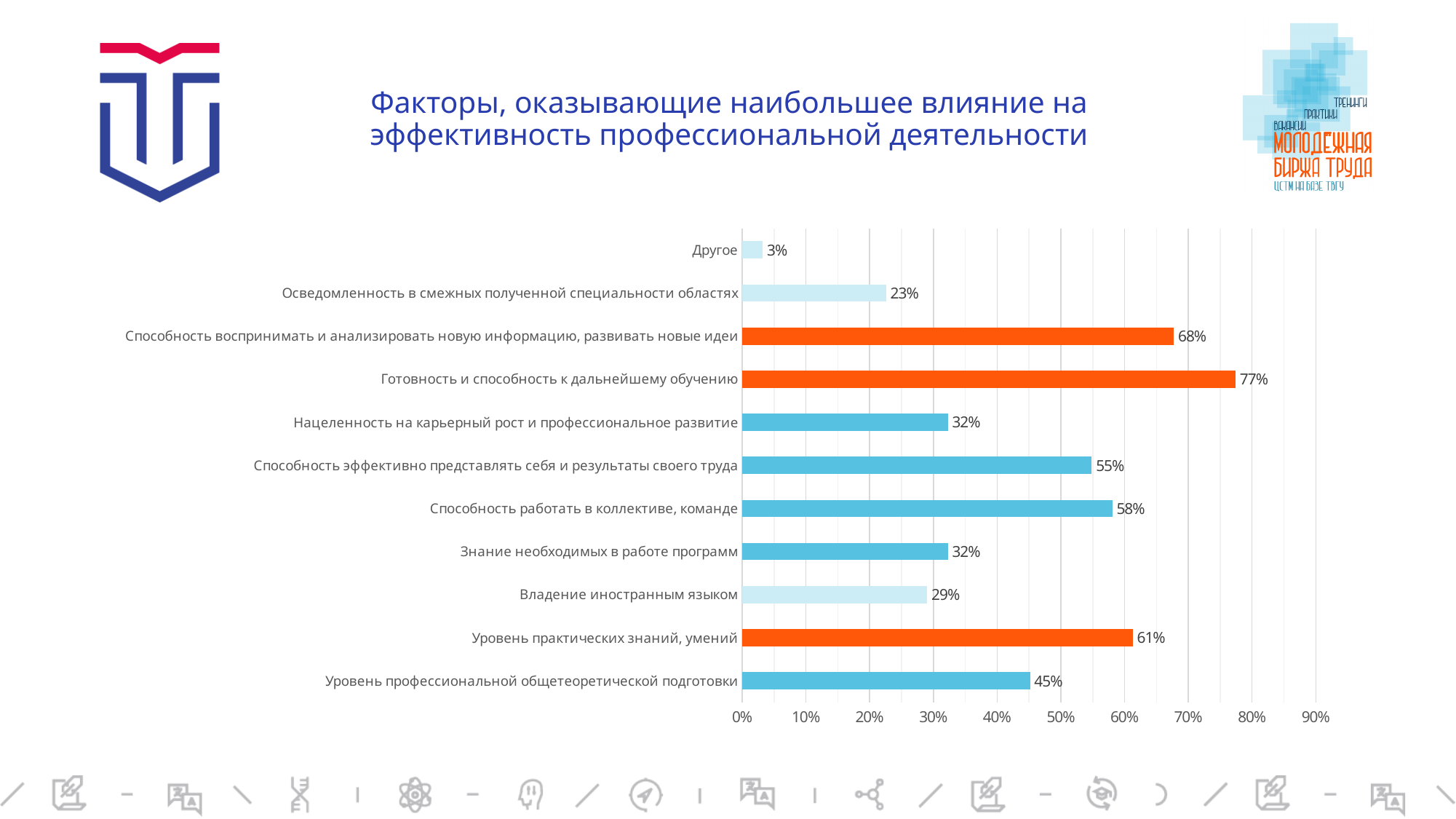
What value is shown for "Уровень практических знаний, умений"? 61% What value is shown for "Готовность и способность к дальнейшему обучению"? 77% How many categories are shown in the chart? 11 Which category has the lowest value? Другое Which is larger: "Способность работать в коллективе, команде" or "Способность эффективно представлять себя и результаты своего труда"? Способность работать в коллективе, команде Which category has the highest value? Готовность и способность к дальнейшему обучению What value is shown for "Владение иностранным языком"? 29% What is the difference between "Готовность и способность к дальнейшему обучению" and "Способность воспринимать и анализировать новую информацию, развивать новые идеи"? 9% What is the difference between "Уровень практических знаний, умений" and "Уровень профессиональной общетеоретической подготовки"? 16% What colour are the bars for the three highest values? Orange What kind of chart is shown on the slide? Bar chart What is the title of the chart on the slide? Факторы, оказывающие наибольшее влияние на эффективность профессиональной деятельности